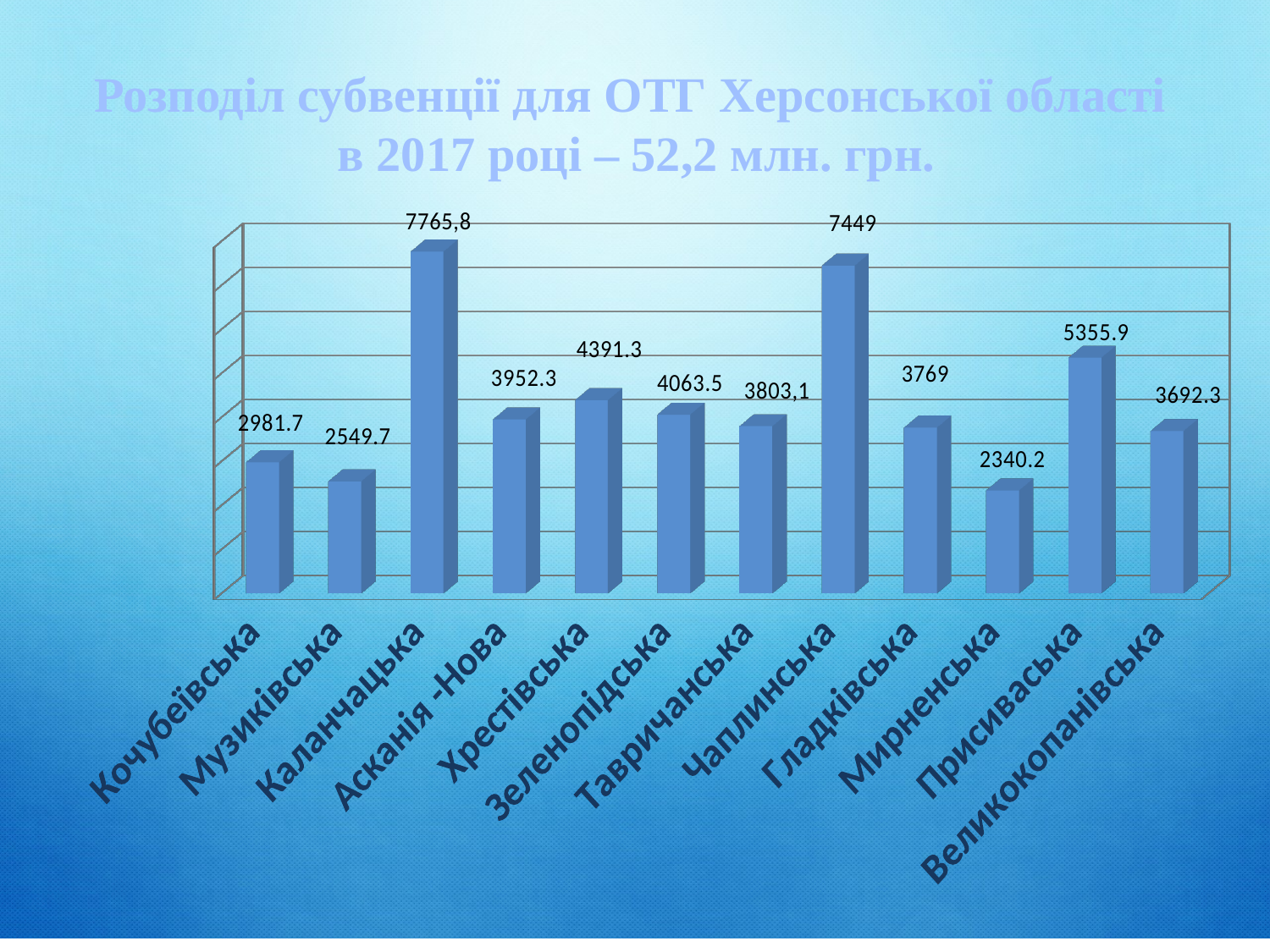
What is the value for Тавричанська? 3803,1 How many categories are shown on the chart? 12 What is the value for Каланчацька? 7765,8 What is the value for Мирненська? 2340.2 What is the value for Присиваська? 5355.9 What is the difference between the values for Присиваська and Мирненська? 3015.7 Which category has the lowest value? Мирненська What is the difference between the values for Каланчацька and Чаплинська? 316.8 What total amount of the subsidy for 2017 is stated in the slide title? 52,2 млн. грн. Which is larger, the value for Асканія-Нова or the value for Великокопанівська? Асканія-Нова Which category has the highest value? Каланчацька What kind of chart is shown on the slide? bar chart